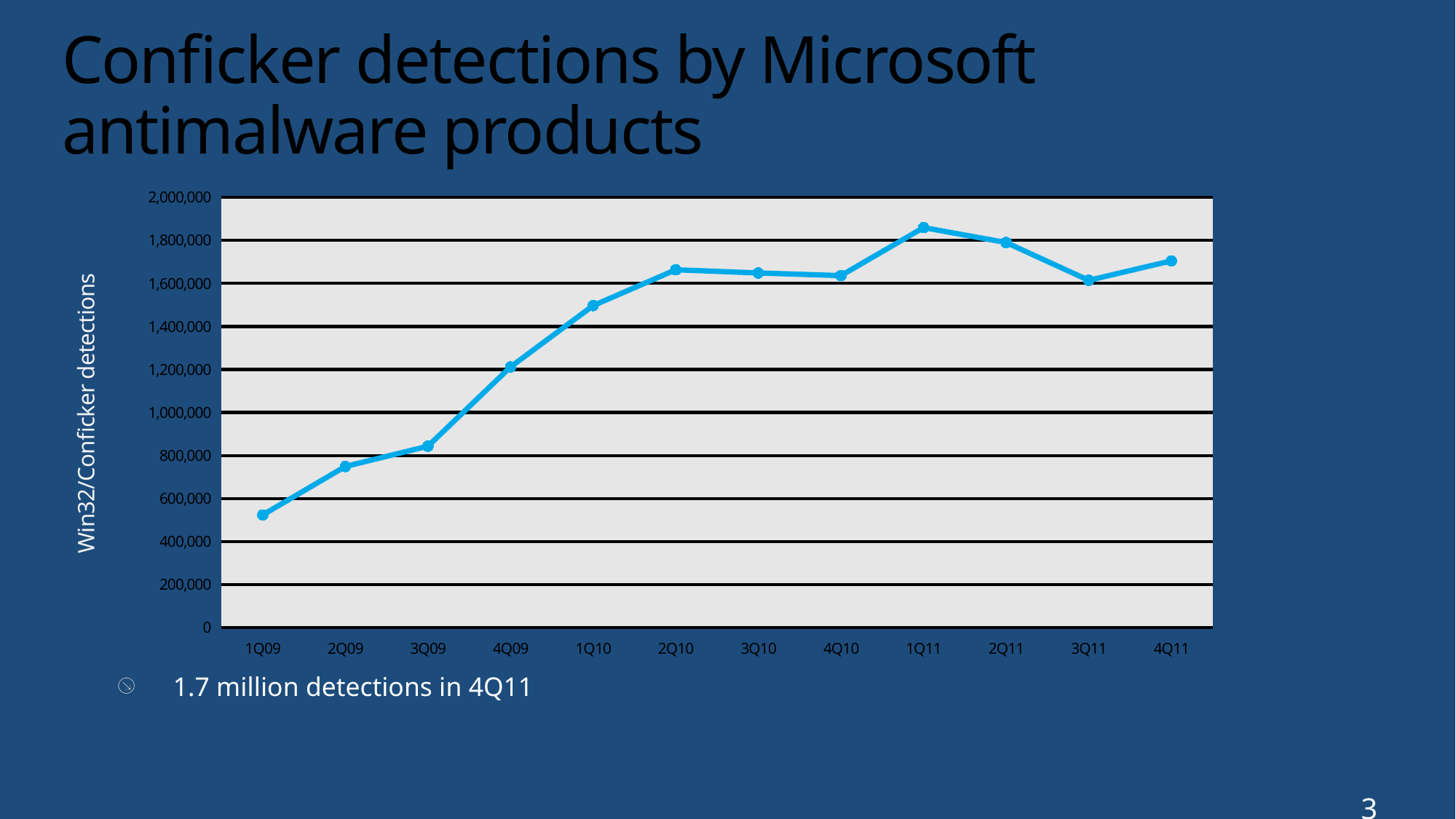
Which quarter has the highest number of Win32/Conficker detections? 1Q11 Is the value for 1Q09 greater or less than 600,000? less Is the value for 3Q09 greater or less than 800,000? greater What kind of chart is shown on the slide? line chart How many quarters are plotted along the x axis? 12 Do detections rise or fall from 1Q09 to 1Q11? rise What is the title of the y axis? Win32/Conficker detections Is the value for 1Q11 greater or less than 1,800,000? greater Which quarter has the lowest number of Win32/Conficker detections? 1Q09 Which quarter has more detections, 1Q11 or 3Q11? 1Q11